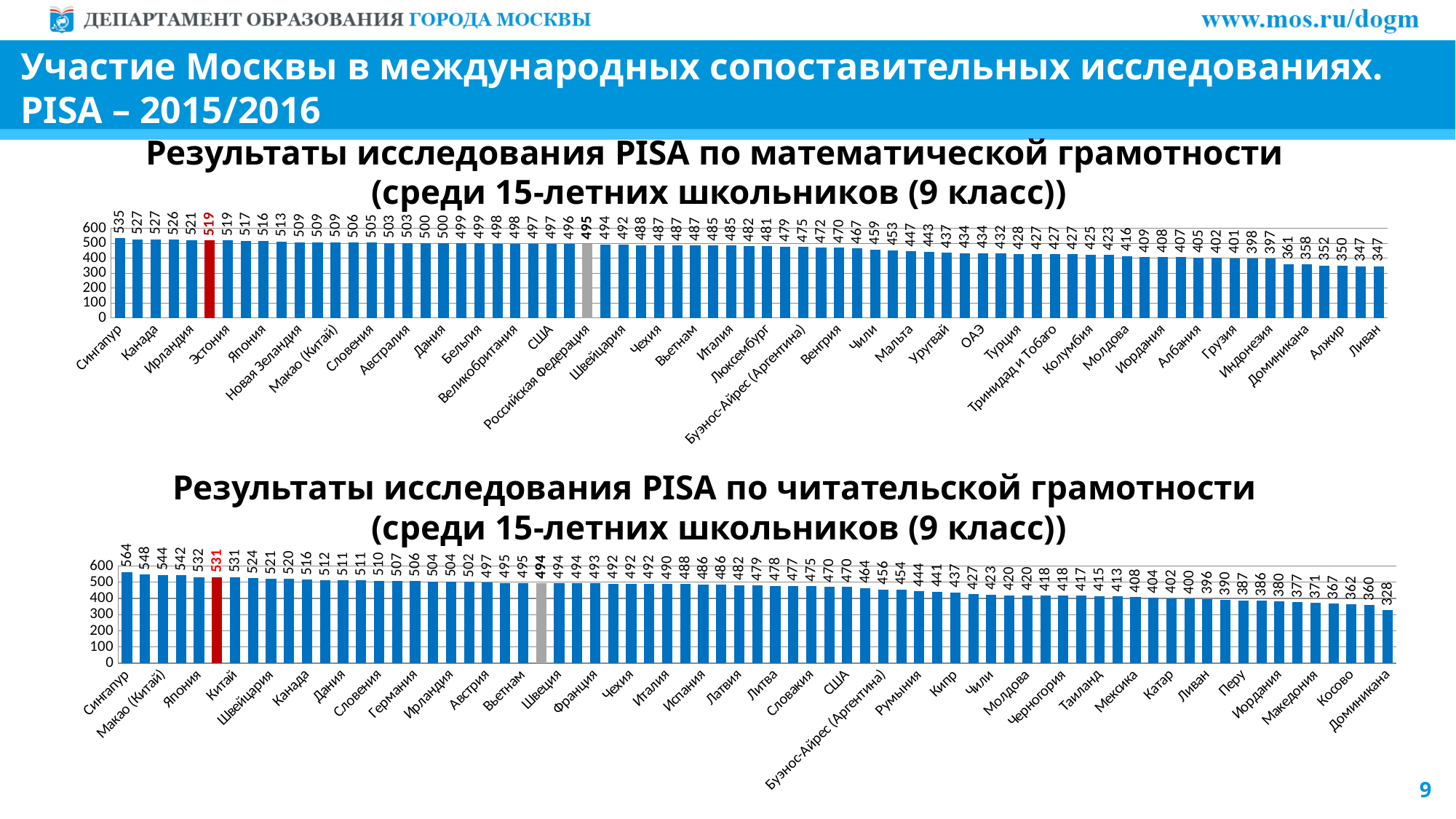
In the top chart (математическая грамотность), what is the difference between the score for Сингапур and the score for Ливан? 188 In the top chart (математическая грамотность), what value is shown on the red highlighted bar? 519 What type of chart is used for the PISA mathematical literacy results (top chart)? bar chart In the bottom chart (читательская грамотность), what value is shown on the red highlighted bar? 531 In the top chart (математическая грамотность), what is the lowest score shown? 347 In the top chart (математическая грамотность), what is the score for Сингапур? 535 In the bottom chart (читательская грамотность), what is the score for Доминикана? 328 In the top chart (математическая грамотность), which country has the highest score? Сингапур In the bottom chart (читательская грамотность), which country has the highest score? Сингапур In the top chart (математическая грамотность), what value is shown on the grey bar for Российская Федерация? 495 In the bottom chart (читательская грамотность), do the scores rise or fall from left to right along the x axis? fall In the bottom chart (читательская грамотность), what is the score for Сингапур? 564